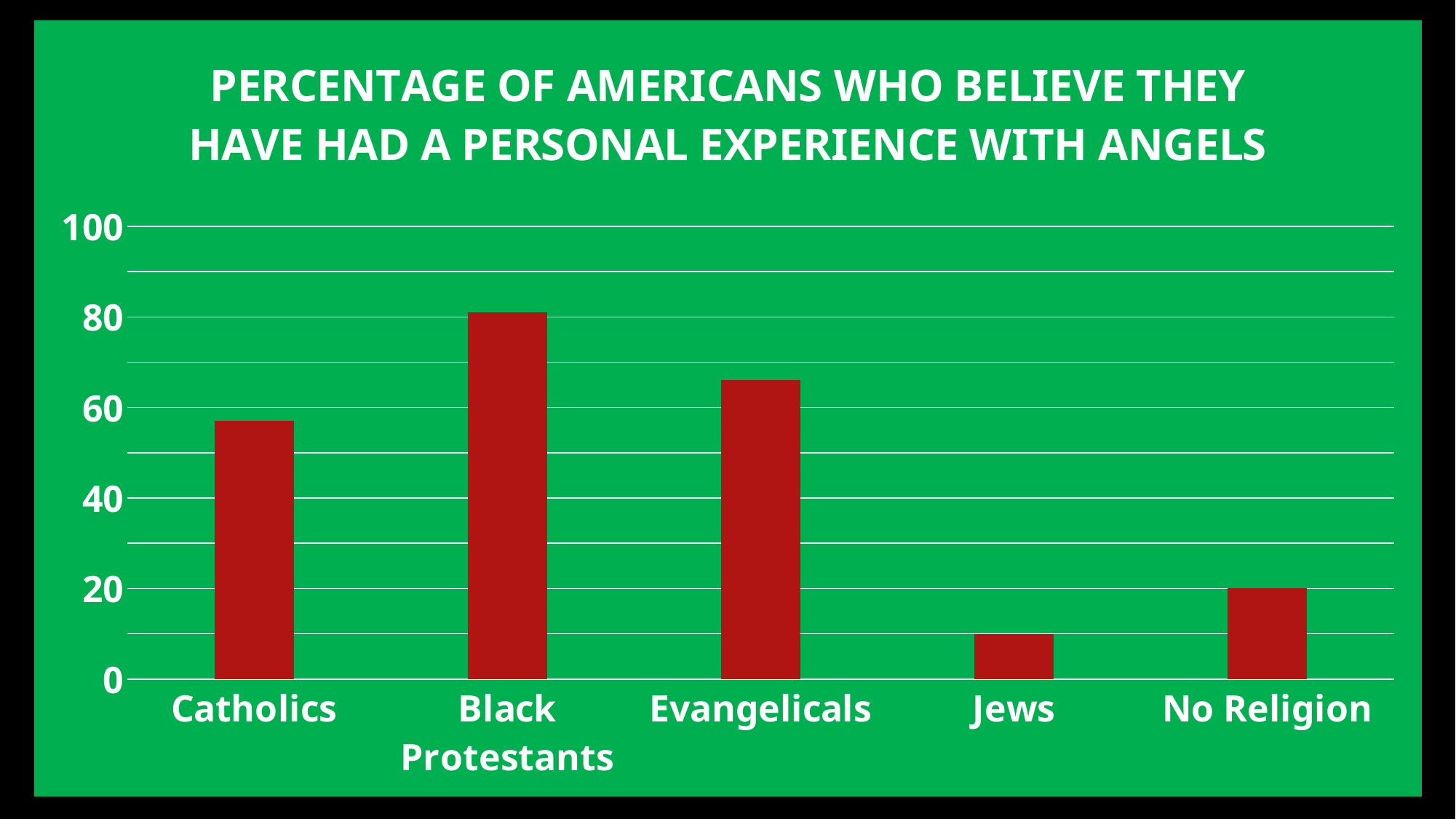
Which is larger, the value for Evangelicals or the value for Catholics? Evangelicals Is the value for Catholics greater or less than 40? greater Is the value for Jews greater or less than 20? less Which category has the lowest bar in the chart? Jews Is the value for Black Protestants greater or less than 60? greater Which category has the highest bar in the chart? Black Protestants What is the title of the chart? PERCENTAGE OF AMERICANS WHO BELIEVE THEY HAVE HAD A PERSONAL EXPERIENCE WITH ANGELS How many categories are shown on the x axis of the chart? 5 What kind of chart is shown on the slide? bar chart